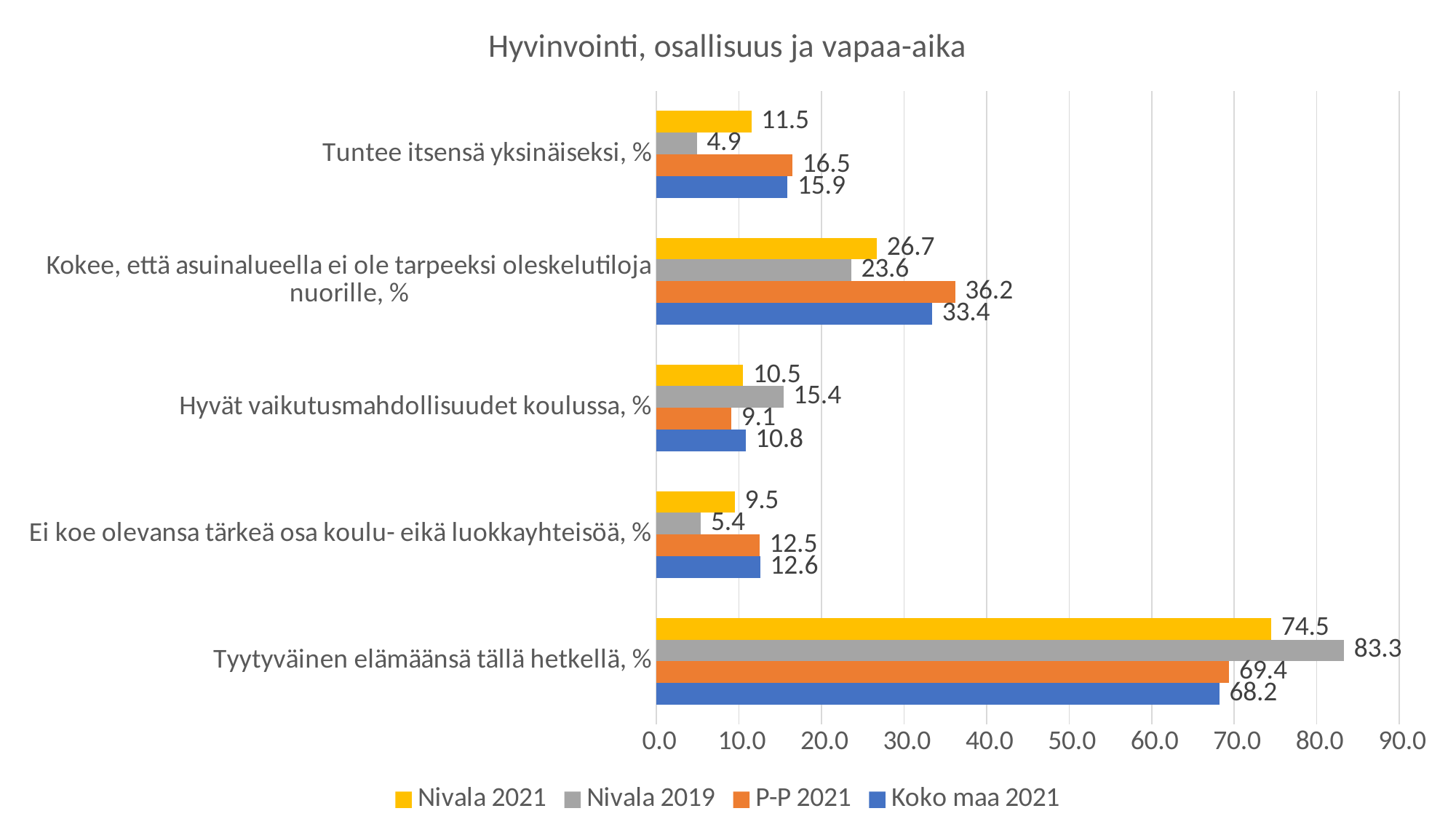
What is the title of the chart? Hyvinvointi, osallisuus ja vapaa-aika How many categories are shown on the chart? 5 Which series has the highest value in the category "Tyytyväinen elämäänsä tällä hetkellä, %"? Nivala 2019 What is the value for Nivala 2021 in the category "Tuntee itsensä yksinäiseksi, %"? 11.5 Which series has the lowest value in the category "Tuntee itsensä yksinäiseksi, %"? Nivala 2019 What kind of chart is shown on the slide? Bar chart Which is larger in the category "Hyvät vaikutusmahdollisuudet koulussa, %": Nivala 2019 or P-P 2021? Nivala 2019 What is the value for Koko maa 2021 in the category "Hyvät vaikutusmahdollisuudet koulussa, %"? 10.8 How many series does the legend list? 4 What is the value for Nivala 2019 in the category "Tyytyväinen elämäänsä tällä hetkellä, %"? 83.3 What is the value for P-P 2021 in the category "Kokee, että asuinalueella ei ole tarpeeksi oleskelutiloja nuorille, %"? 36.2 What is the difference between the Nivala 2021 and Nivala 2019 values in the category "Ei koe olevansa tärkeä osa koulu- eikä luokkayhteisöä, %"? 4.1